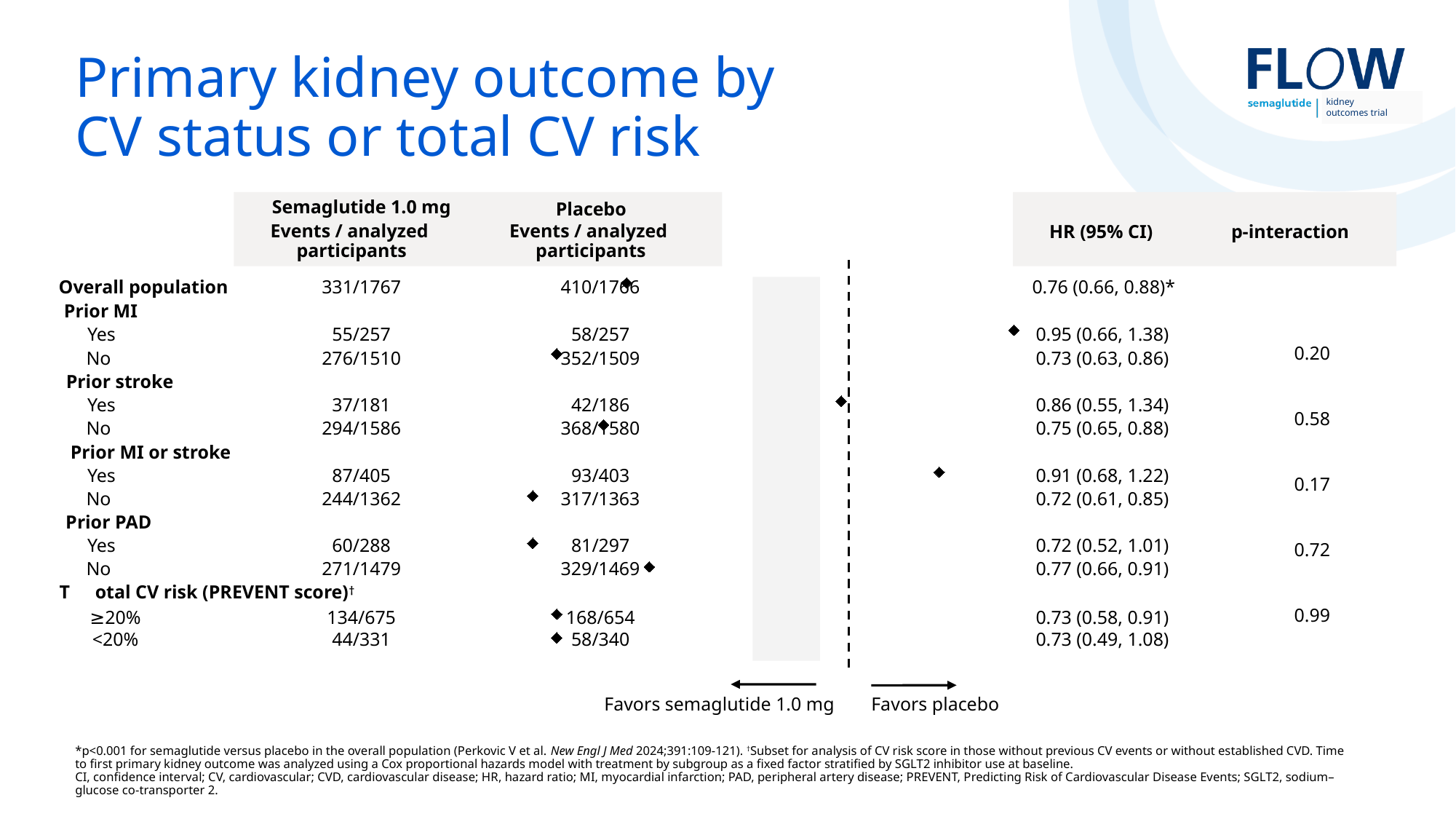
What is the HR (95% CI) for the overall population? 0.76 (0.66, 0.88)* Is the hazard ratio larger for prior stroke Yes or prior stroke No? Prior stroke Yes What is the difference between the hazard ratios for prior MI Yes and prior MI No? 0.22 Which subgroup has the lowest p-interaction value? Prior MI or stroke What does the arrow pointing left below the plot indicate? Favors semaglutide 1.0 mg Which subgroup has the highest p-interaction value? Total CV risk (PREVENT score) What is the HR (95% CI) for participants with prior MI (Yes)? 0.95 (0.66, 1.38) What are the events / analyzed participants for semaglutide 1.0 mg in the prior PAD Yes subgroup? 60/288 Which subgroup has the highest hazard ratio? Prior MI, Yes What kind of chart is shown on the slide? Forest plot What is the p-interaction value for the prior stroke subgroup? 0.58 What are the events / analyzed participants for placebo in the total CV risk ≥20% subgroup? 168/654